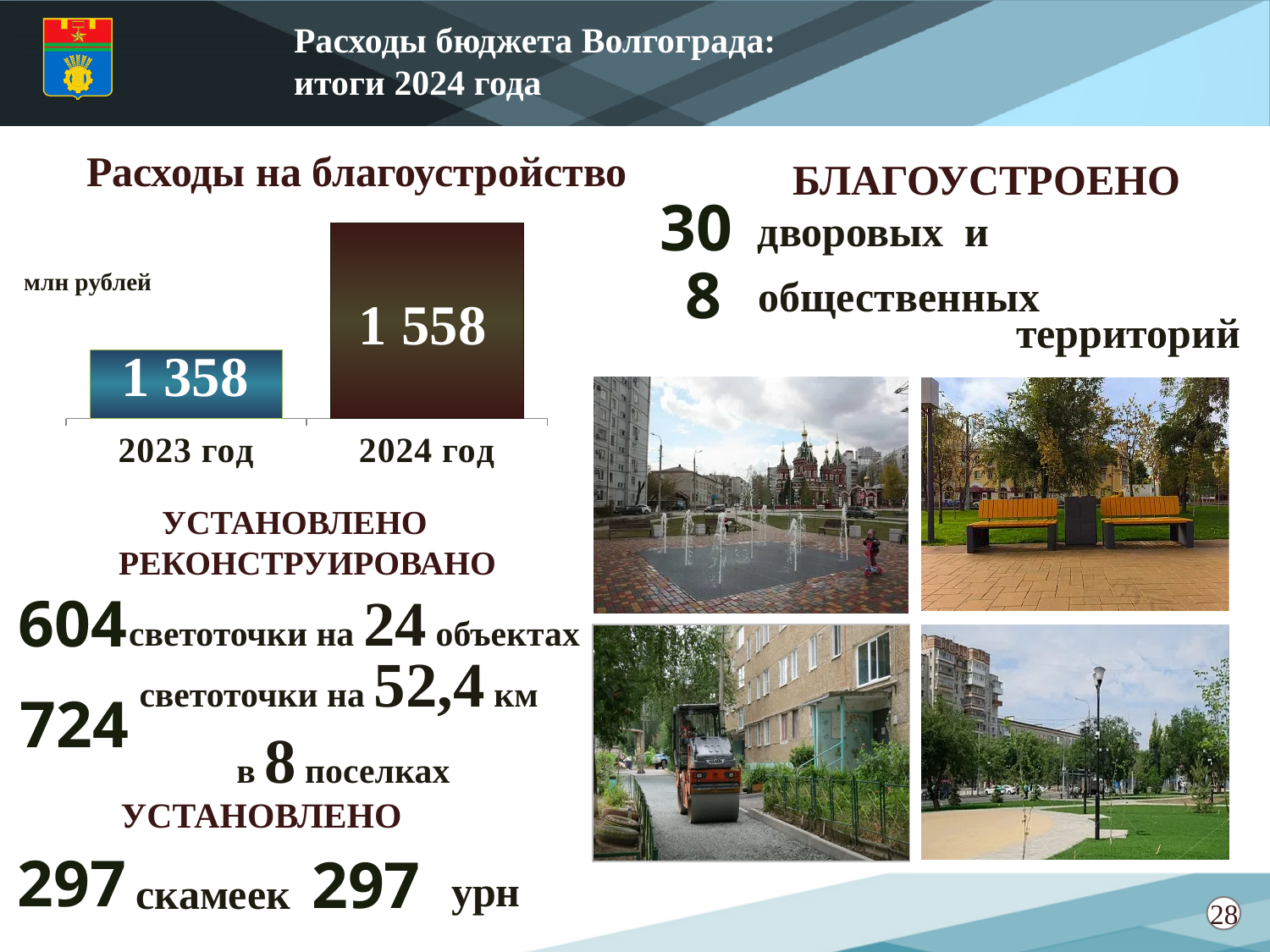
In the chart 'Расходы на благоустройство', is the value for 2024 год larger or smaller than the value for 2023 год? larger What is the value for 2024 год in the chart 'Расходы на благоустройство'? 1 558 How many categories (years) are shown in the chart 'Расходы на благоустройство'? 2 What kind of chart is 'Расходы на благоустройство'? bar chart What is the value for 2023 год in the chart 'Расходы на благоустройство'? 1 358 Do the values in the chart 'Расходы на благоустройство' rise or fall from 2023 год to 2024 год? rise What is the title of the bar chart on the slide? Расходы на благоустройство By how much does the value for 2024 год exceed the value for 2023 год in the chart 'Расходы на благоустройство'? 200 Which year has the higher value in the chart 'Расходы на благоустройство'? 2024 год Which year has the lower value in the chart 'Расходы на благоустройство'? 2023 год What unit is indicated for the values in the chart 'Расходы на благоустройство'? млн рублей